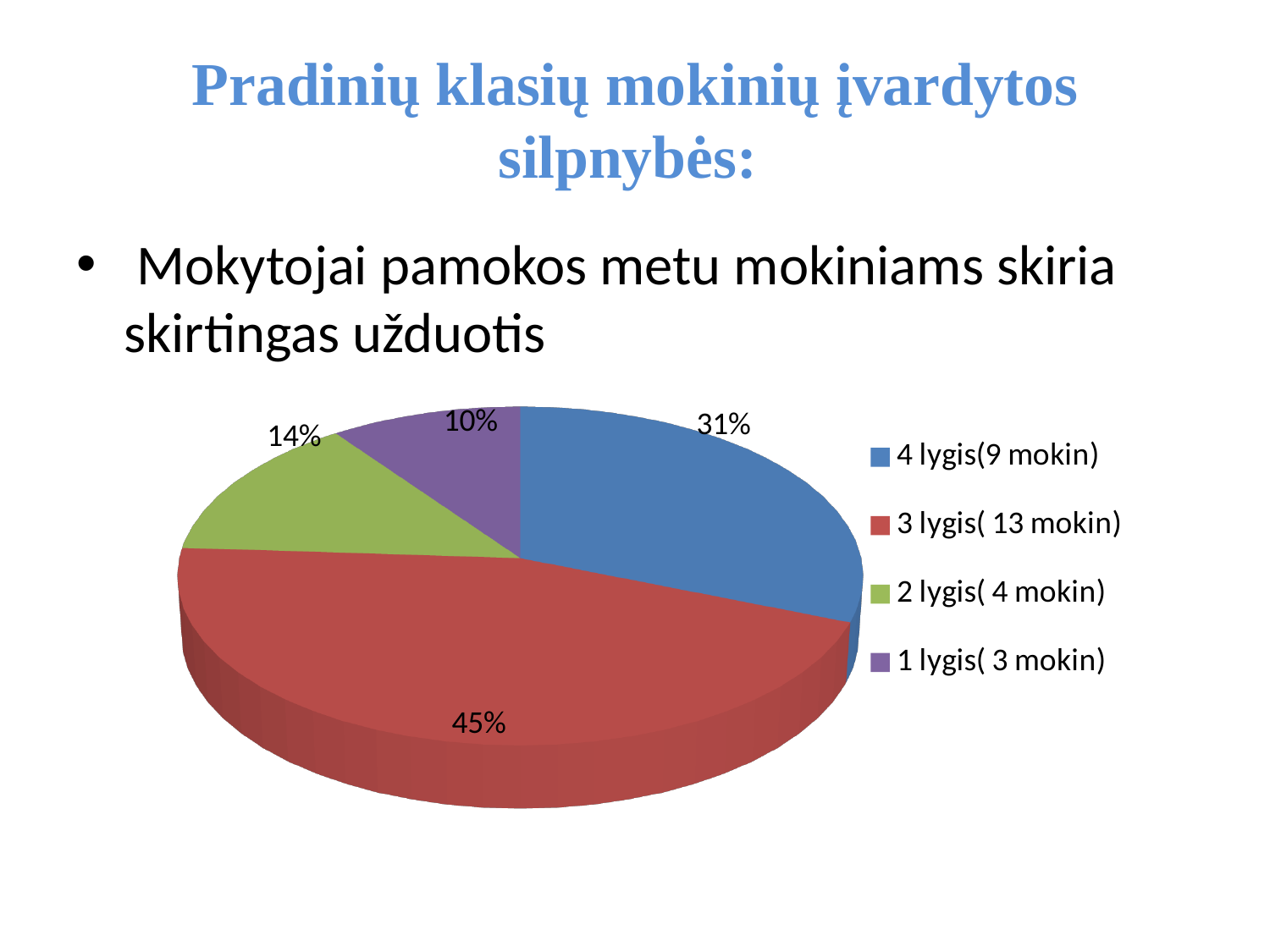
Which category has the largest slice of the pie? 3 lygis( 13 mokin) How many slices does the pie chart have? 4 What is the difference in percentage points between the "3 lygis( 13 mokin)" slice and the "4 lygis(9 mokin)" slice? 14 What share of the pie does "2 lygis( 4 mokin)" have? 14% What colour is the slice for "4 lygis(9 mokin)"? blue How many entries does the legend list? 4 Which slice is larger: "2 lygis( 4 mokin)" or "1 lygis( 3 mokin)"? 2 lygis( 4 mokin) What share of the pie does "1 lygis( 3 mokin)" have? 10% Which category has the smallest slice of the pie? 1 lygis( 3 mokin) What kind of chart is shown on the slide? pie chart What share of the pie does "4 lygis(9 mokin)" have? 31%